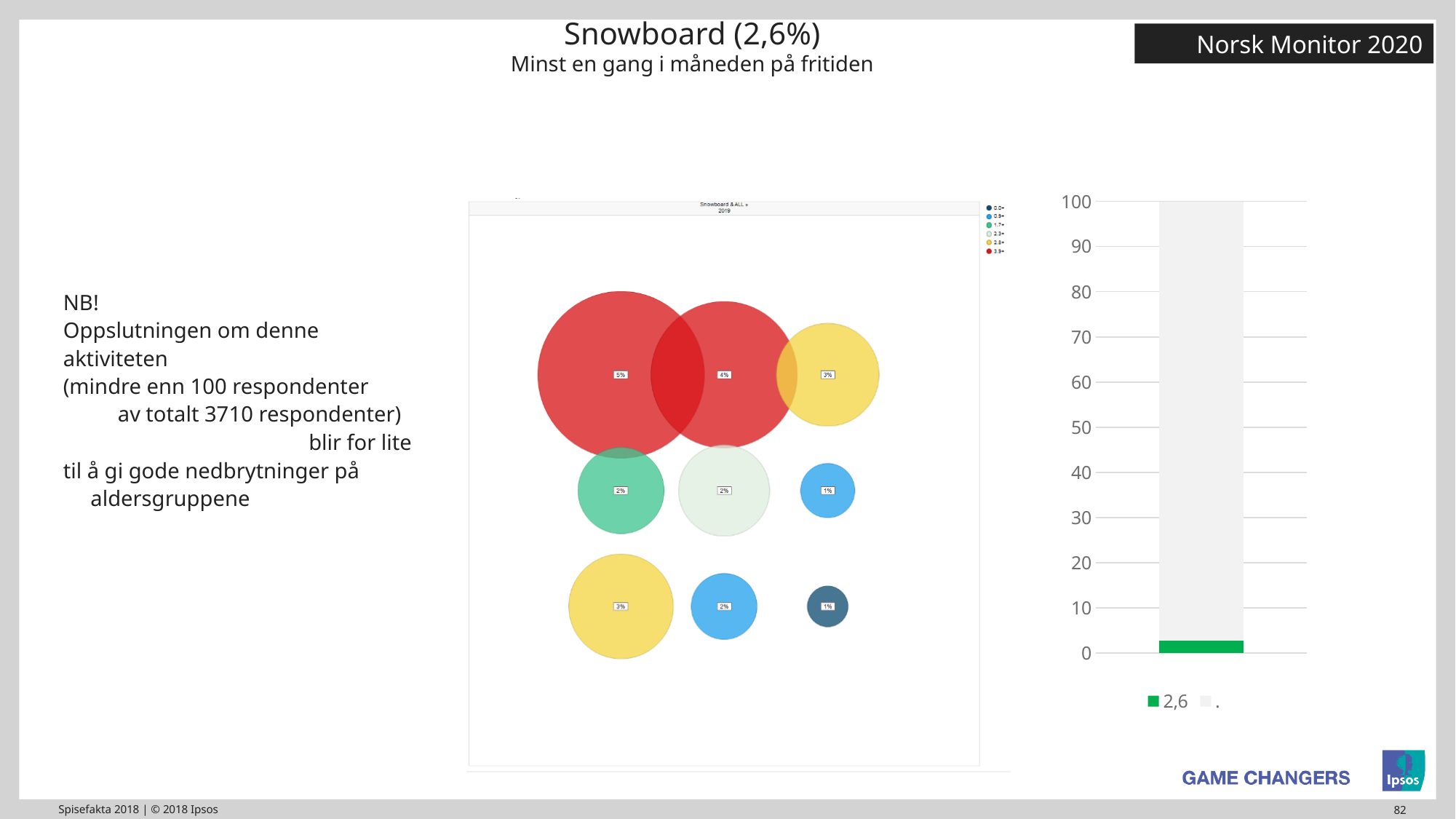
How many series does the legend of the bar chart on the right list? 2 What is the highest value shown on the vertical axis of the bar chart on the right? 100 What kind of chart is the chart in the centre of the slide? bubble chart How many bubbles are plotted in the bubble chart in the centre of the slide? 9 What is the lowest percentage label shown on any bubble in the bubble chart in the centre of the slide? 1% How many bars does the bar chart on the right contain? 1 In the bar chart on the right, is the green value greater or less than 10? less What is the highest percentage label shown on any bubble in the bubble chart in the centre of the slide? 5% What kind of chart is the chart on the right of the slide? bar chart In the bar chart on the right, what colour is the series labelled 2,6 in the legend? green